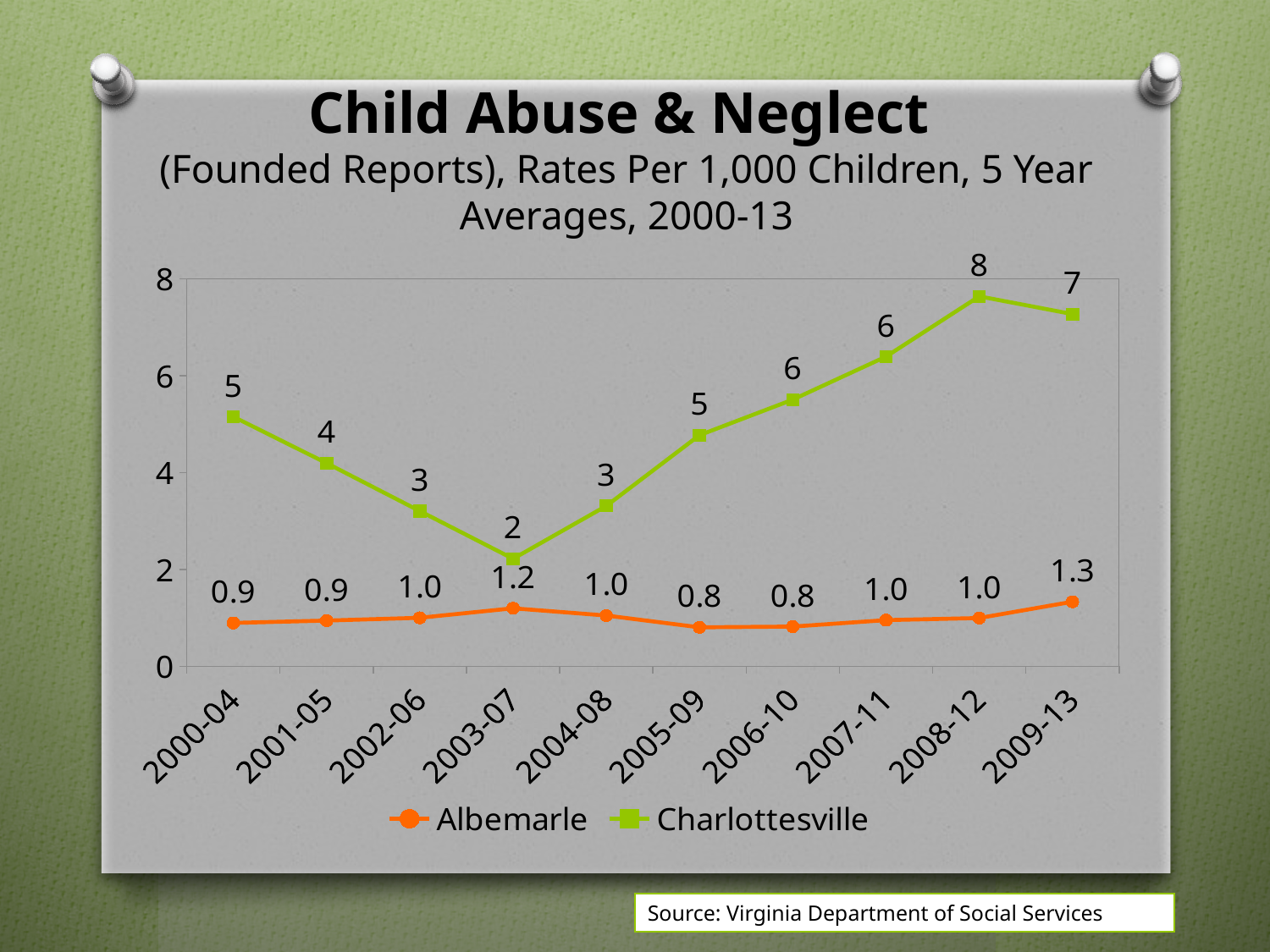
What is the Charlottesville rate for 2008-12? 8 What is the Albemarle rate for 2003-07? 1.2 In which period is the Charlottesville rate lowest? 2003-07 What is the difference between the Charlottesville rates for 2008-12 and 2009-13? 1 How many series does the legend list? 2 In which period is the Albemarle rate highest? 2009-13 Which series has the higher rate in 2000-04, Albemarle or Charlottesville? Charlottesville How many time periods are plotted along the x axis? 10 What kind of chart is shown on the slide? line chart In which period is the Charlottesville rate highest? 2008-12 Does the Charlottesville rate rise or fall from 2003-07 to 2008-12? rise Which colour is used for the Albemarle line? orange